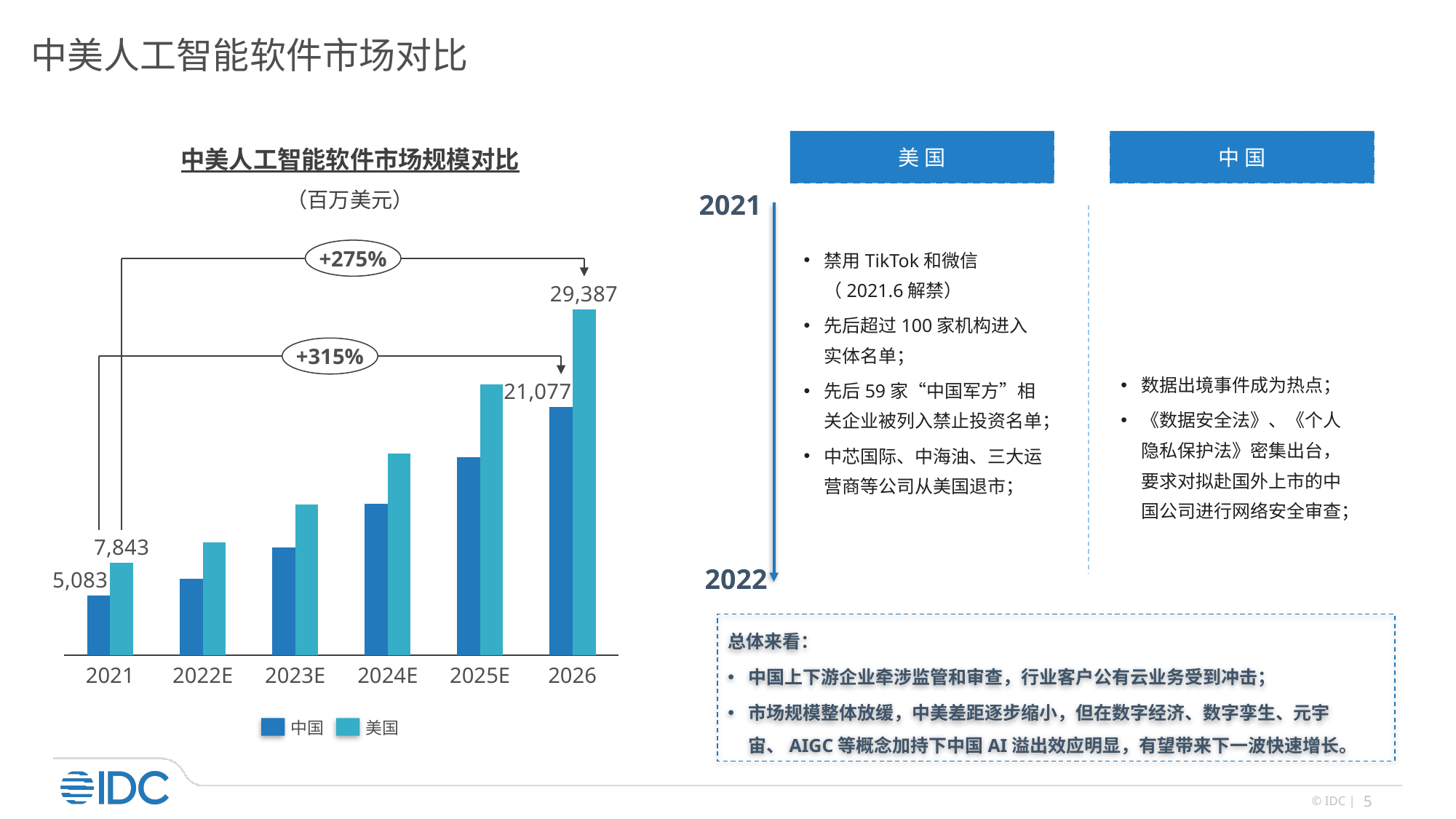
What is the value for 中国 in 2026 in the chart? 21,077 What is the value for 美国 in 2026 in the chart? 29,387 How many years are shown on the x axis of the chart? 6 How many series does the chart legend list? 2 Which series has the larger value in 2024E, 中国 or 美国? 美国 What is the value for 中国 in 2021 in the chart 中美人工智能软件市场规模对比? 5,083 What kind of chart is shown on the slide? Bar chart What is the value for 美国 in 2021 in the chart? 7,843 What is the difference between the 美国 and 中国 values in 2026? 8,310 In which year does 美国 reach its highest value in the chart? 2026 In which year is the 中国 value lowest in the chart? 2021 What is the difference between the 美国 and 中国 values in 2021? 2,760